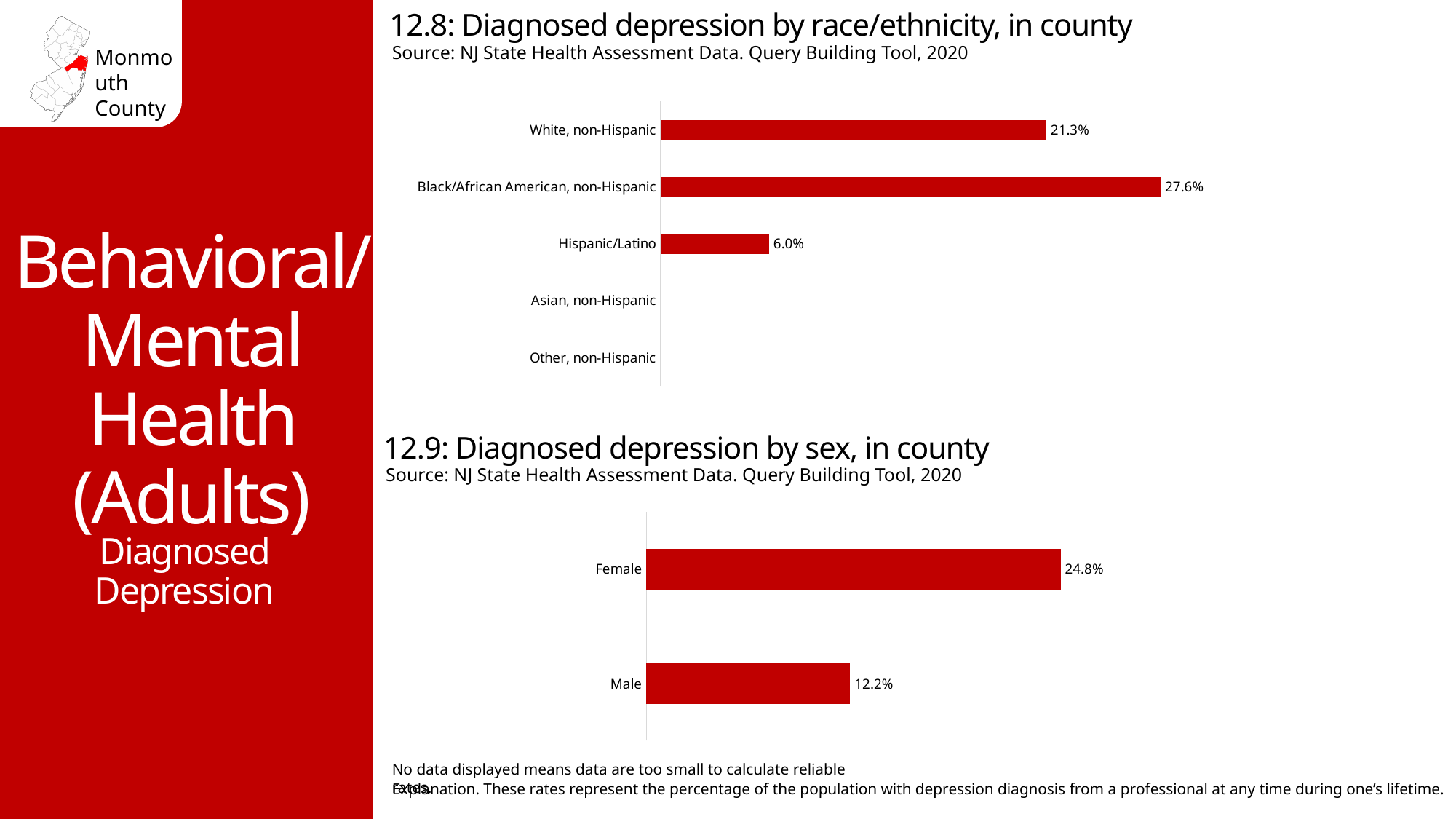
In the chart '12.9: Diagnosed depression by sex, in county', what is the value for Male? 12.2% In the chart '12.8: Diagnosed depression by race/ethnicity, in county', what is the difference between the values for Black/African American, non-Hispanic and White, non-Hispanic? 6.3% In the chart '12.9: Diagnosed depression by sex, in county', what is the value for Female? 24.8% What type of chart is '12.9: Diagnosed depression by sex, in county'? Bar chart In the chart '12.8: Diagnosed depression by race/ethnicity, in county', how many categories are listed on the axis? 5 In the chart '12.8: Diagnosed depression by race/ethnicity, in county', what is the value for Hispanic/Latino? 6.0% In the chart '12.8: Diagnosed depression by race/ethnicity, in county', which category has the highest value? Black/African American, non-Hispanic In the chart '12.8: Diagnosed depression by race/ethnicity, in county', what is the value for Black/African American, non-Hispanic? 27.6% In the chart '12.9: Diagnosed depression by sex, in county', what is the difference between the Female and Male values? 12.6% In the chart '12.8: Diagnosed depression by race/ethnicity, in county', which categories have no bar displayed? Asian, non-Hispanic and Other, non-Hispanic In the chart '12.8: Diagnosed depression by race/ethnicity, in county', which is larger, the value for White, non-Hispanic or Hispanic/Latino? White, non-Hispanic In the chart '12.9: Diagnosed depression by sex, in county', which category has the lowest value? Male